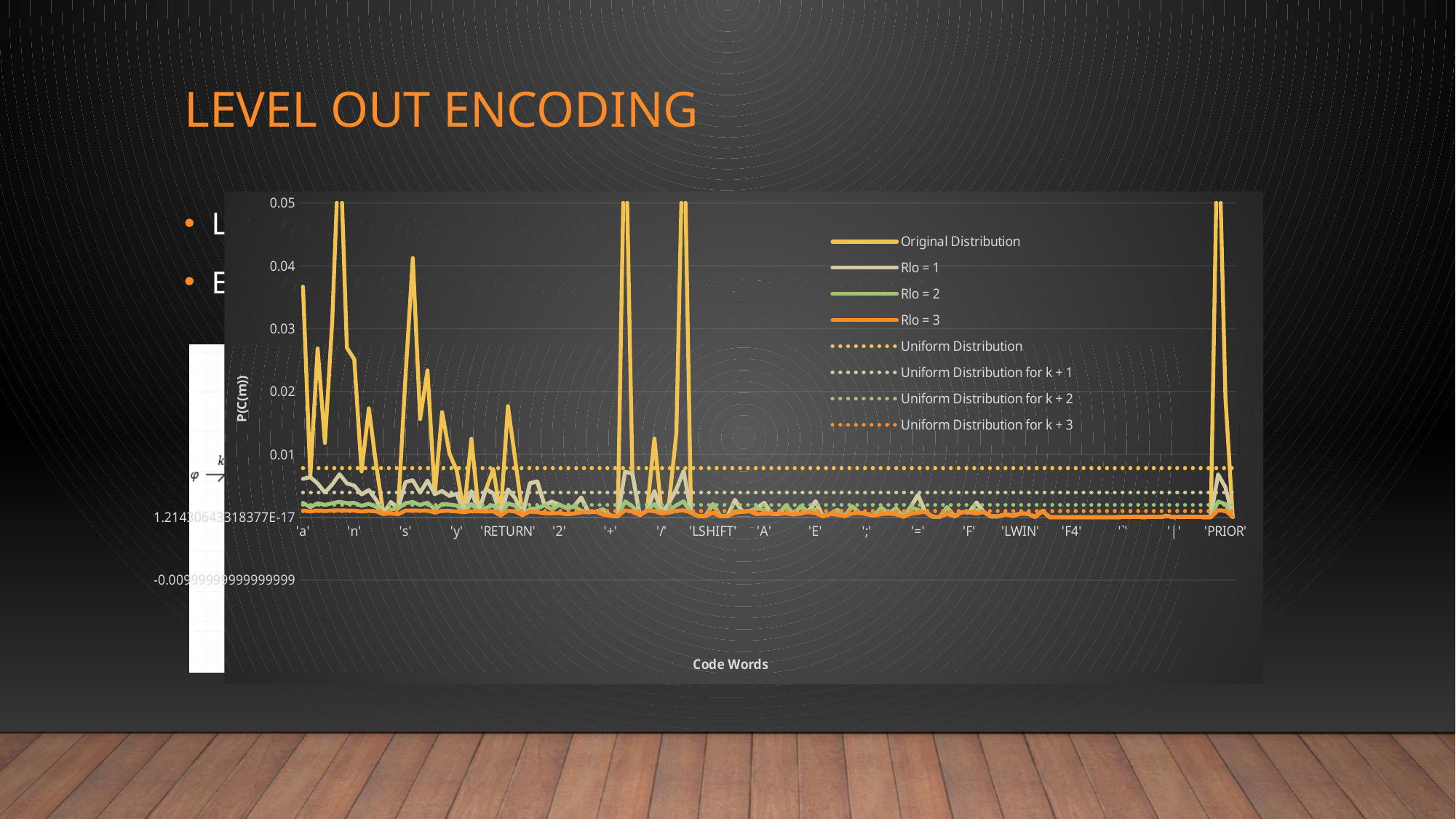
Is the Uniform Distribution line greater or less than 0.01? less What is the title of the x axis of the chart? Code Words What kind of chart is shown on the slide? line chart Is the Rlo = 1 value at 'a' greater or less than 0.01? less Is the Original Distribution value at 'a' greater or less than 0.03? greater Which series reaches the highest value on the chart? Original Distribution At 'a', which is larger: the Original Distribution value or the Rlo = 1 value? Original Distribution Which of the solid-line series stays lowest across the code words? Rlo = 3 How many series does the chart's legend list? 8 What is the title of the y axis of the chart? P(C(m))